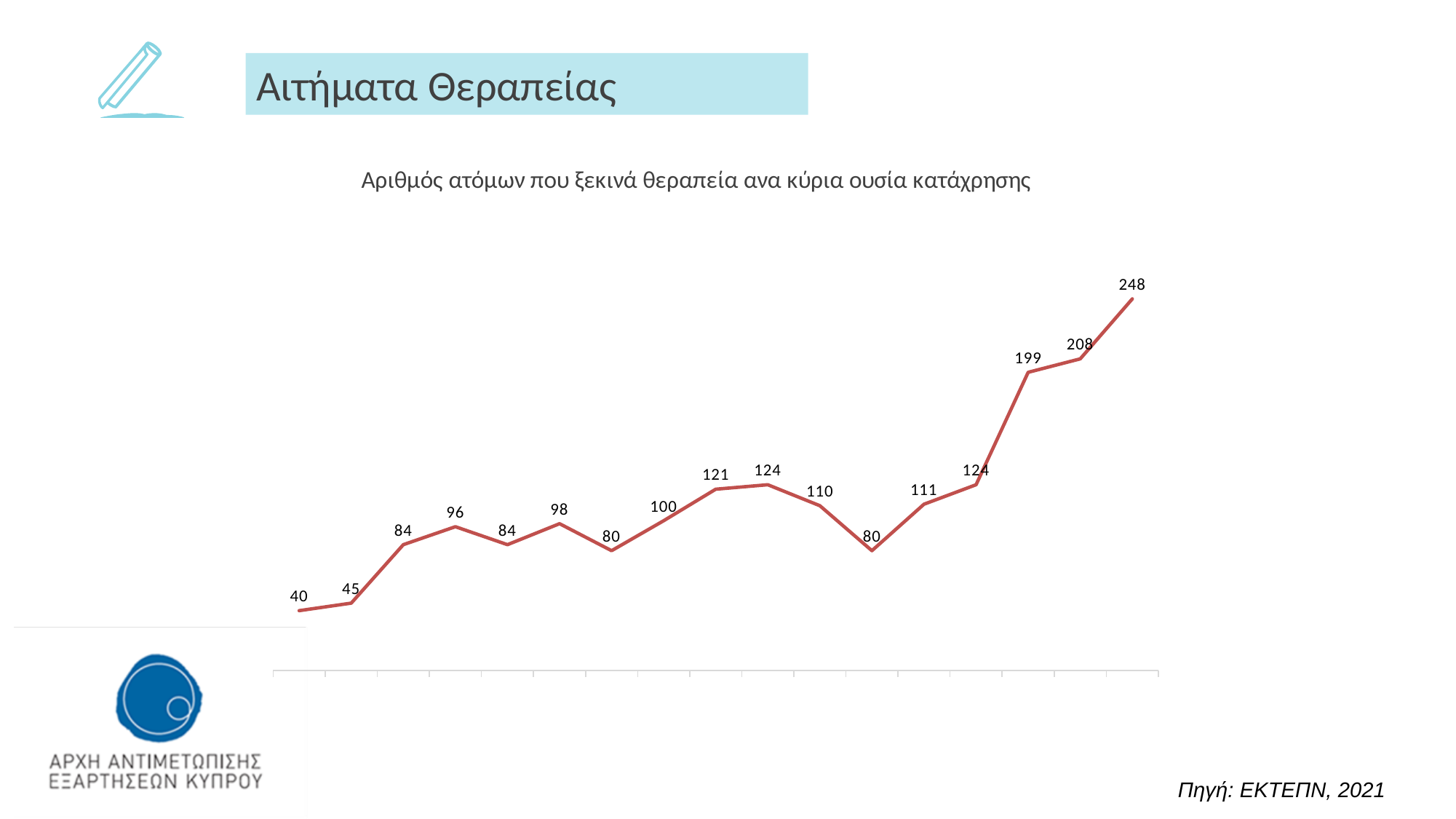
What is the difference between the last point (248) and the first point (40) on the line chart? 208 How many data points are plotted on the line chart? 17 What is the title printed above the line chart? Αριθμός ατόμων που ξεκινά θεραπεία ανα κύρια ουσία κατάχρησης What kind of chart is shown on the slide? Line chart What is the value of the first (leftmost) point on the line chart? 40 What is the lowest value labelled on the line chart? 40 Which is larger: the value of the second point (45) or the value of the third point (84)? 84 What is the value of the last (rightmost) point on the line chart? 248 What is the difference between the two highest labelled values, 248 and 208? 40 What colour is the line in the chart? Red What is the highest value labelled on the line chart? 248 Overall, do the values rise or fall from left to right along the x axis? Rise